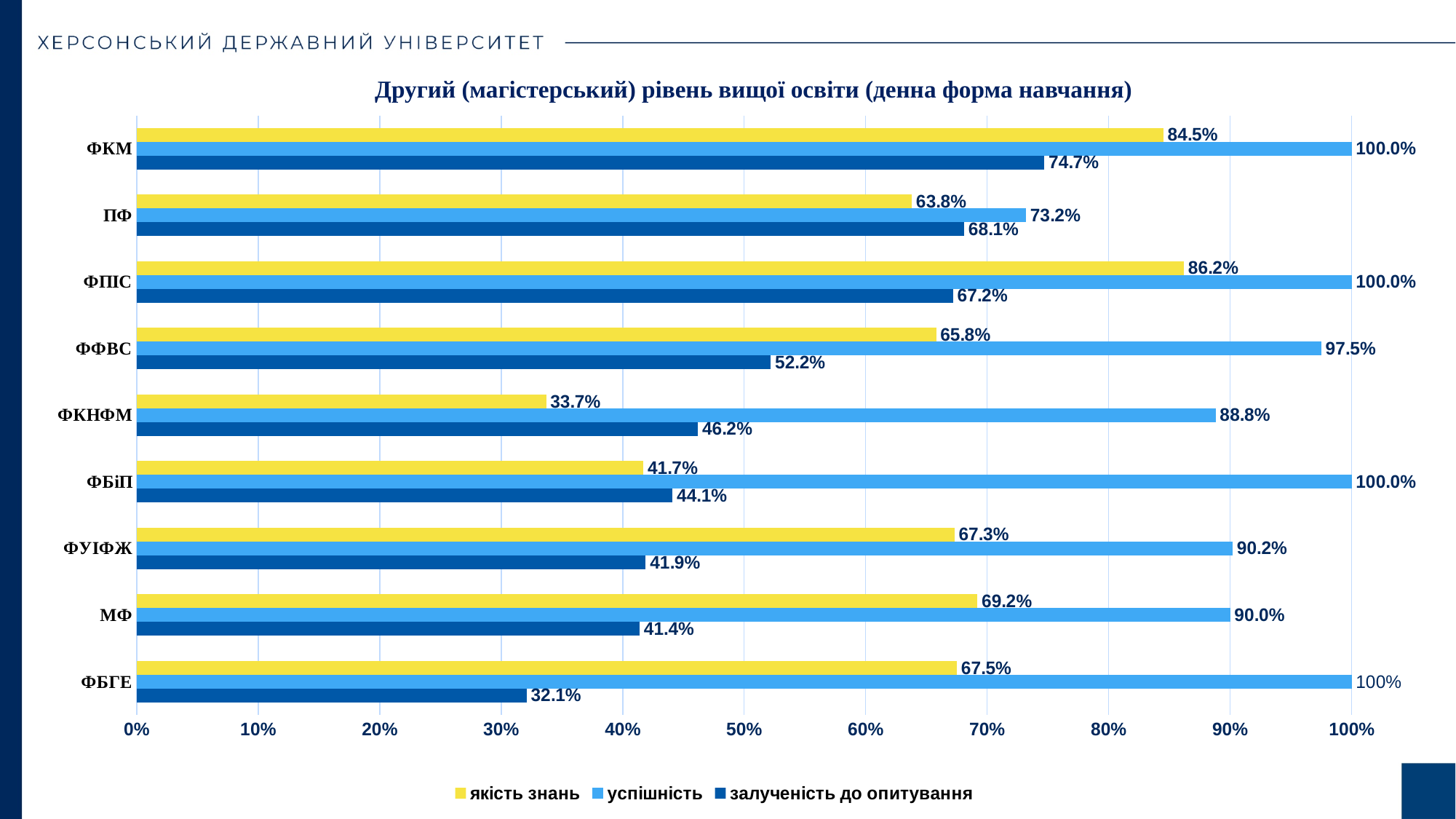
Which faculty has the highest якість знань value? ФПІС Which faculty has the lowest якість знань value? ФКНФМ How many faculties are shown on the chart? 9 Which faculty has the lowest успішність value? ПФ What is the залученість до опитування value for ФБГЕ? 32.1% What type of chart is shown on the slide? Bar chart Which is larger for ФКНФМ: якість знань or залученість до опитування? залученість до опитування What is the якість знань value for ФКМ? 84.5% How many series does the legend list? 3 What is the успішність value for ПФ? 73.2% Which faculty has the lowest залученість до опитування value? ФБГЕ What is the difference between the якість знань and залученість до опитування values for ФКМ? 9.8 percentage points